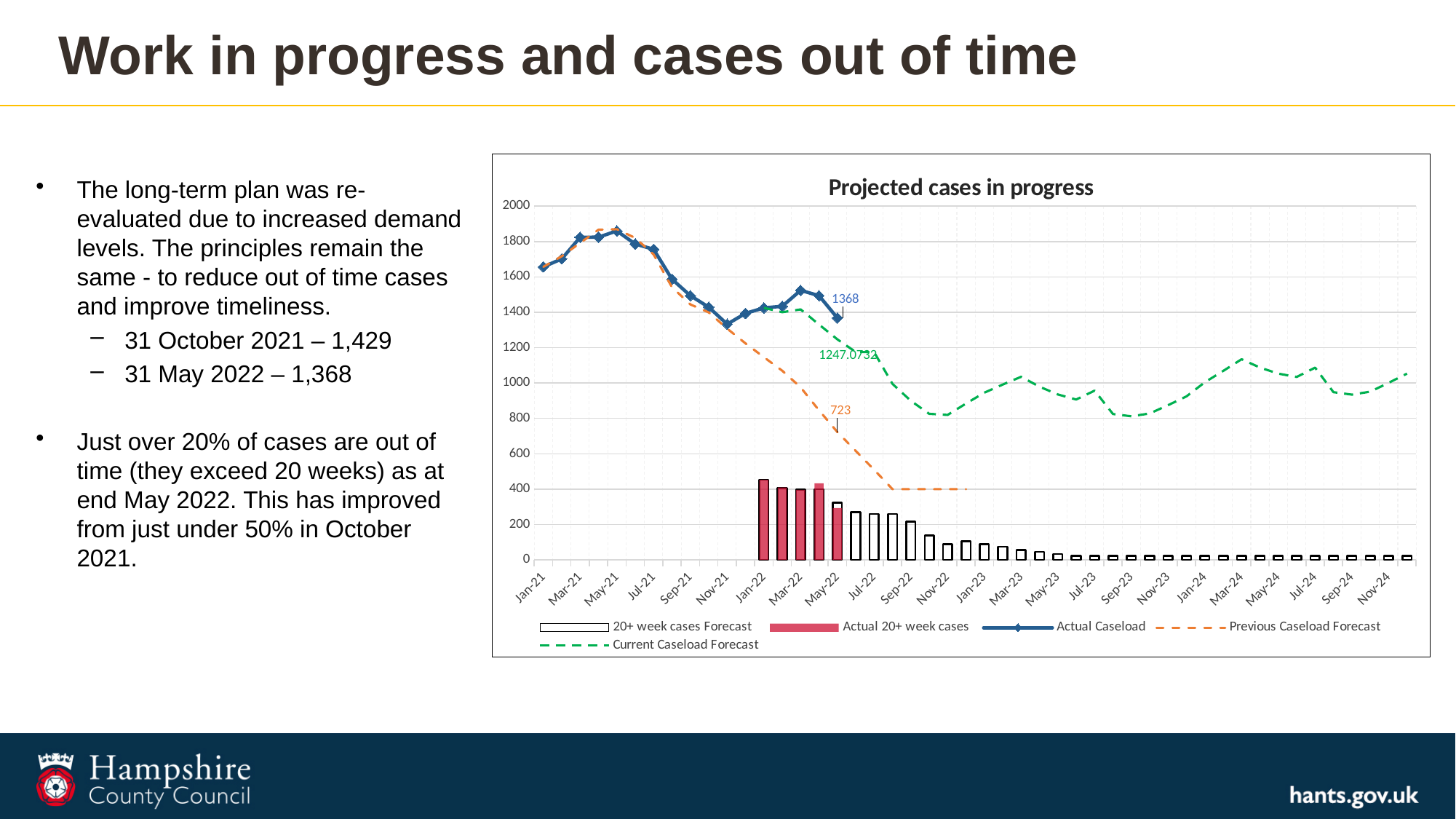
What is the labelled value of the Current Caseload Forecast series at May-22? 1247.0732 How many series does the chart legend list? 5 What is the title of the chart? Projected cases in progress What colour are the Actual 20+ week cases bars? Red What kind of chart is shown on the slide? Combined bar and line chart Does the Actual Caseload series rise or fall between May-21 and Nov-21? fall Is the Previous Caseload Forecast value for Nov-22 greater or less than 600? less What is the labelled value of the Actual Caseload series at May-22? 1368 What is the labelled value of the Previous Caseload Forecast series at May-22? 723 Is the Actual Caseload value for Jan-21 greater or less than 1400? greater At May-22, which is larger: the Actual Caseload or the Previous Caseload Forecast? Actual Caseload What is the difference between the labelled Actual Caseload (1368) and the labelled Previous Caseload Forecast (723) at May-22? 645